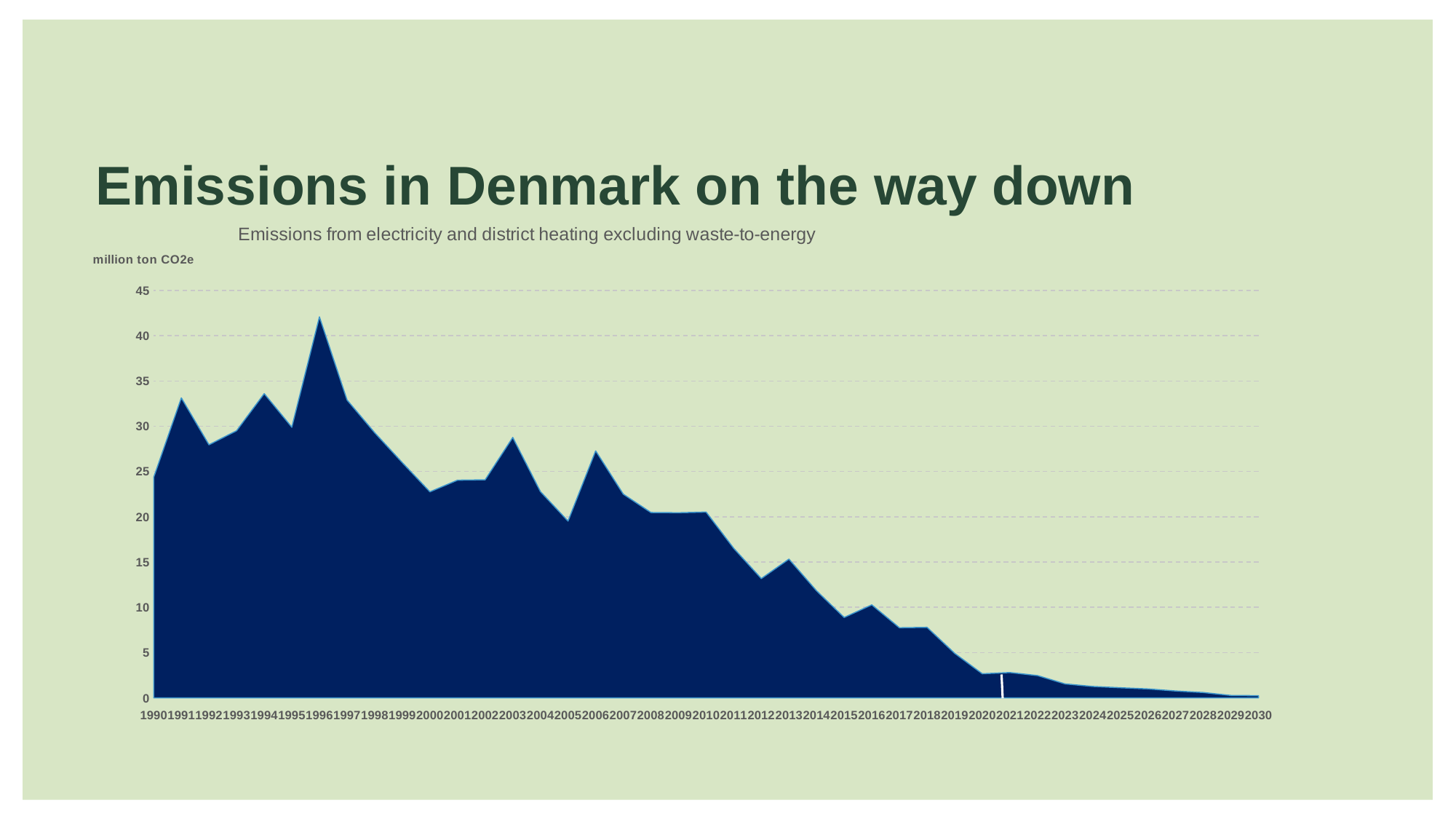
Is the value for 1996 greater or less than 40? greater Is the value for 2012 greater or less than 15? less Is the value for 2020 greater or less than 5? less What unit is shown on the vertical axis label? million ton CO2e What is the subtitle of the chart? Emissions from electricity and district heating excluding waste-to-energy Which year has the highest emissions value in the chart? 1996 Overall, do emissions rise or fall from 1990 to 2030? Fall What kind of chart is shown on the slide? Area chart Which year has the larger emissions value, 1996 or 2003? 1996 Which year has the lowest emissions value in the chart? 2030